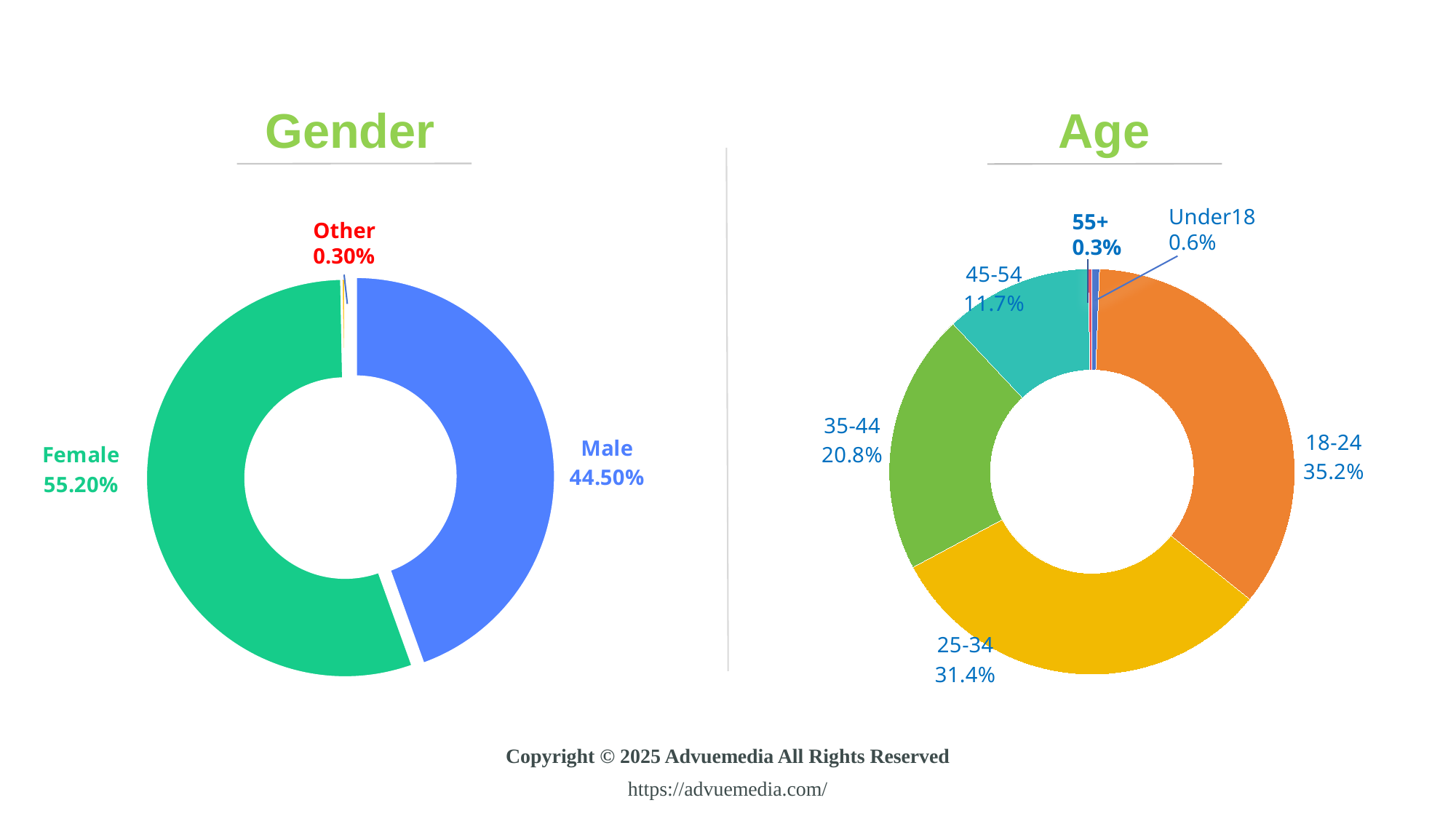
In the Gender chart, what share is Other? 0.30% In the Gender chart, which category has the largest share? Female In the Age chart, what share is the 18-24 group? 35.2% In the Gender chart, what is the difference between the Female and Male shares? 10.70% In the Age chart, which is larger, the 25-34 share or the 35-44 share? 25-34 In the Age chart, what is the difference between the 18-24 and 25-34 shares? 3.8% In the Gender chart, what share is Female? 55.20% In the Gender chart, how many categories are shown? 3 In the Gender chart, what share is Male? 44.50% In the Age chart, what share is the 45-54 group? 11.7% What kind of chart is the Age chart? Pie (doughnut) chart In the Age chart, which age group has the smallest share? 55+